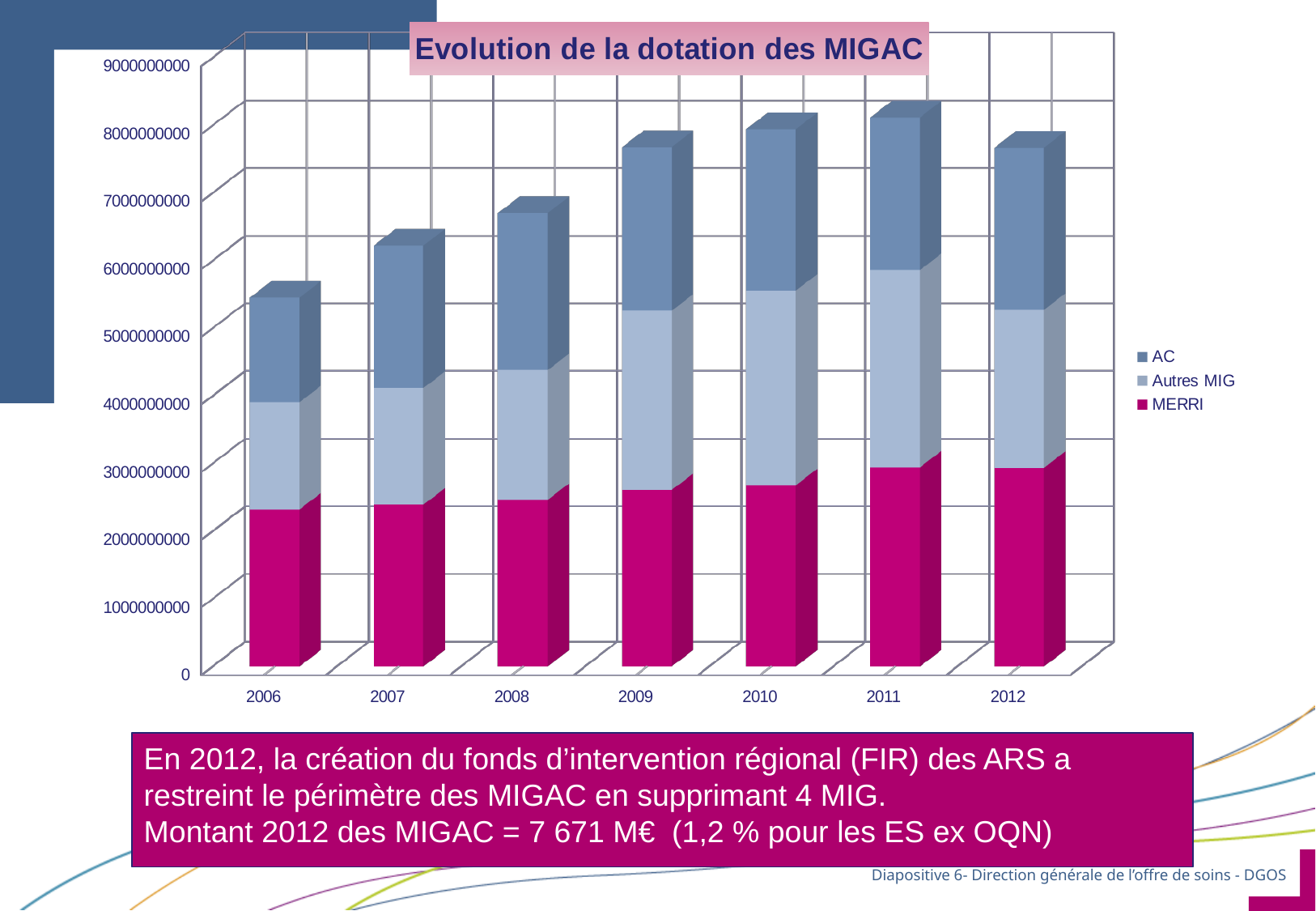
Which year has the lowest total bar? 2006 What is the title of the chart? Evolution de la dotation des MIGAC Do the total bars rise or fall from 2006 to 2011? rise How many years are shown on the x axis? 7 Which year has the larger total bar, 2008 or 2009? 2009 Is the total bar for 2011 greater or less than 7000000000? greater Is the MERRI value for 2006 greater or less than 3000000000? less Which series are listed in the legend? AC, Autres MIG, MERRI What kind of chart is shown on the slide? Stacked bar chart Which year has the highest total bar? 2011 Is the total bar for 2006 greater or less than 6000000000? less How many series does the legend list? 3